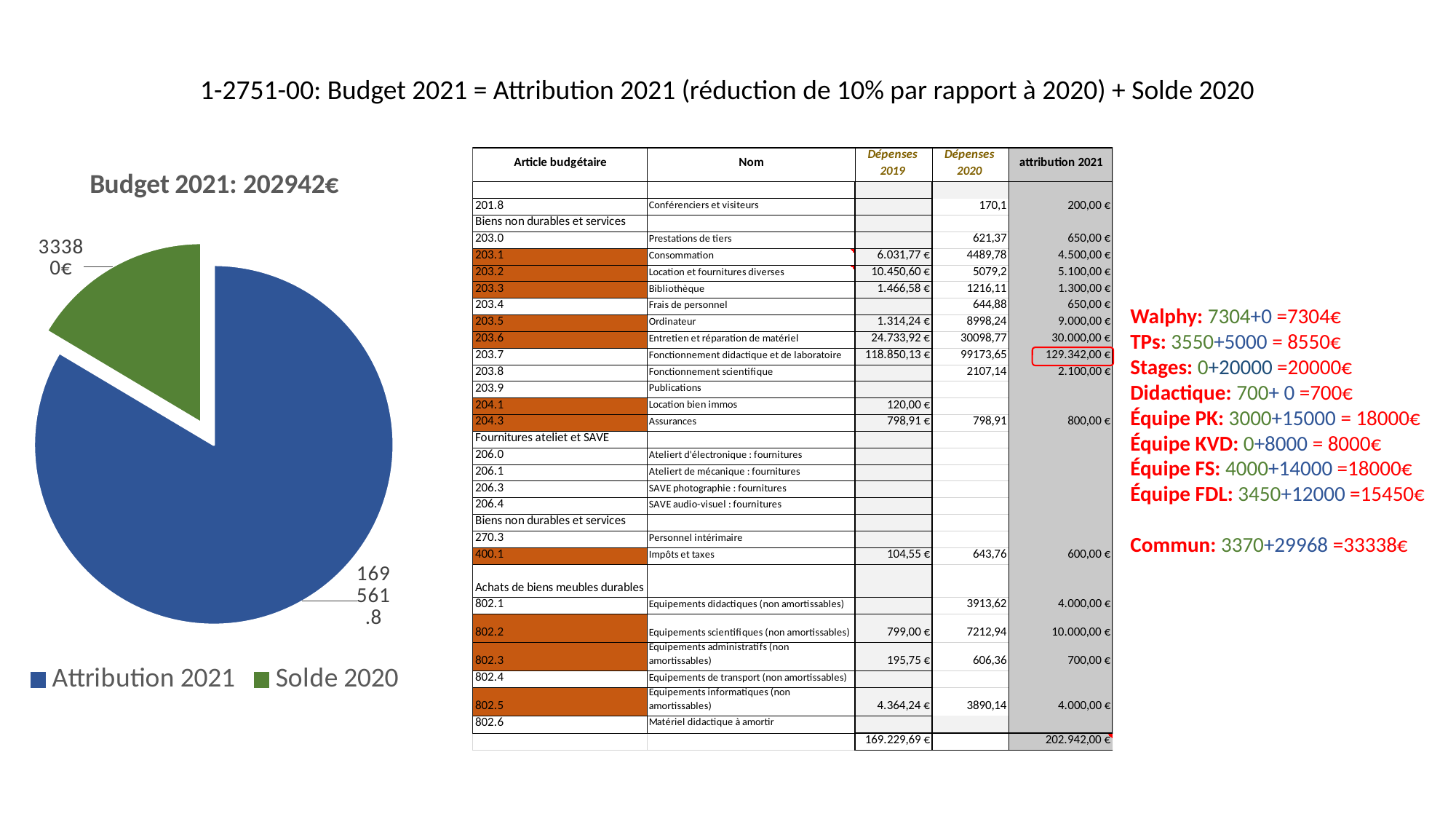
How many entries does the pie chart's legend list? 2 What value is labelled on the Attribution 2021 slice of the pie chart? 169561.8 What value is labelled on the Solde 2020 slice of the pie chart? 33380€ In the pie chart, which is larger: Attribution 2021 or Solde 2020? Attribution 2021 Does the Attribution 2021 slice make up more or less than half of the pie chart? more How many slices does the pie chart have? 2 What kind of chart is shown on the left of the slide? pie chart Which slice of the pie chart is the largest? Attribution 2021 What is the title of the pie chart? Budget 2021: 202942€ What colour is the Solde 2020 slice in the pie chart? green Which slice of the pie chart is the smallest? Solde 2020